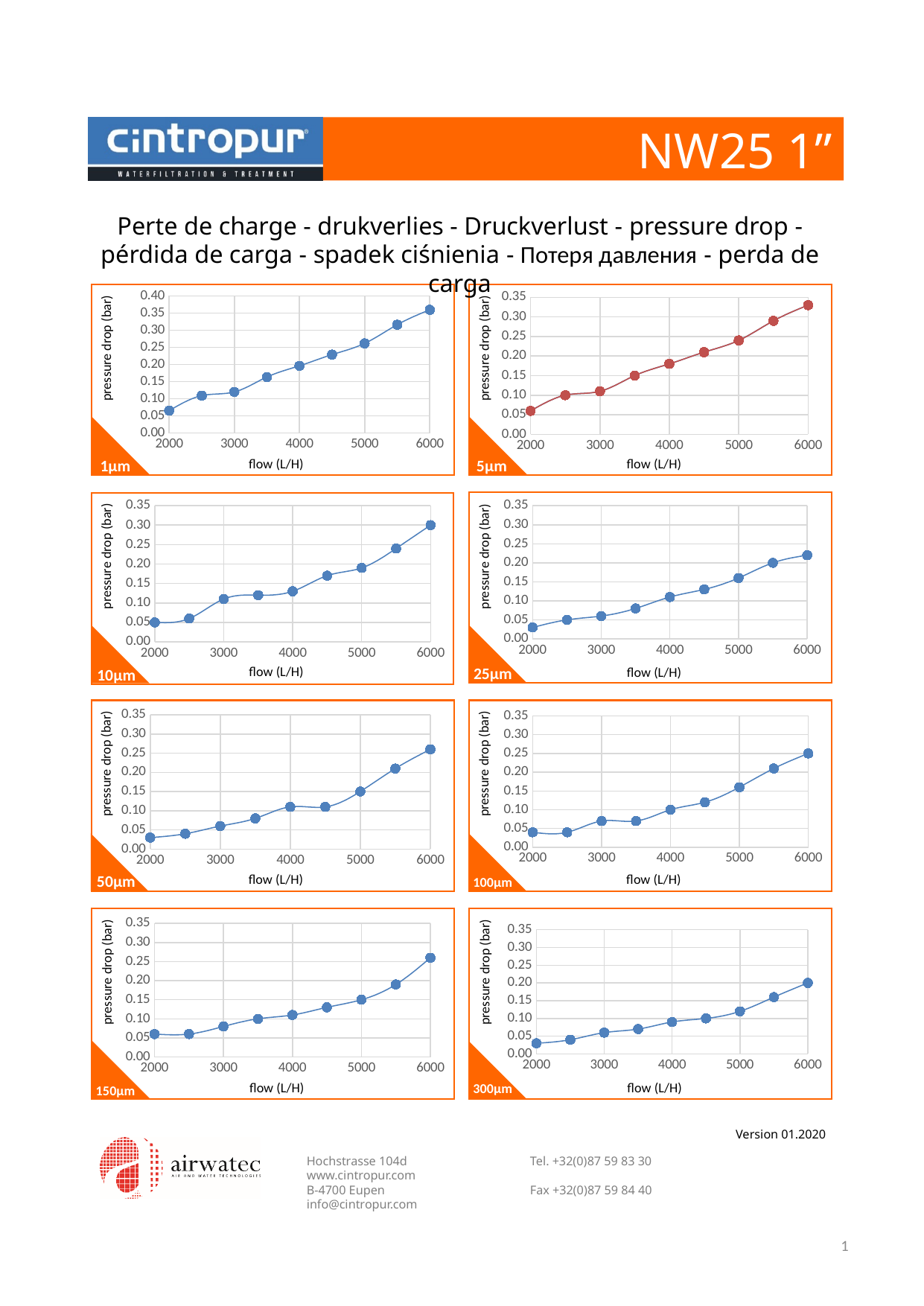
Which of the eight charts uses a red line instead of blue? 5µm In the 300µm chart, is the pressure drop at 6000 L/H greater or less than 0.25? less How many data points are plotted in the 10µm chart? 9 In the 1µm chart, at which flow value is the pressure drop lowest? 2000 What is the y-axis label on the 150µm chart? pressure drop (bar) In the 25µm chart, is the pressure drop at 6000 L/H greater or less than 0.25? less Which is larger: the pressure drop at 6000 L/H in the 1µm chart or in the 300µm chart? 1µm chart In the 1µm chart, is the pressure drop at 6000 L/H greater or less than 0.30? greater In the 5µm chart, does the pressure drop rise or fall as flow increases? rises What kind of chart is the 1µm chart? line chart In the 25µm chart, at which flow value is the pressure drop highest? 6000